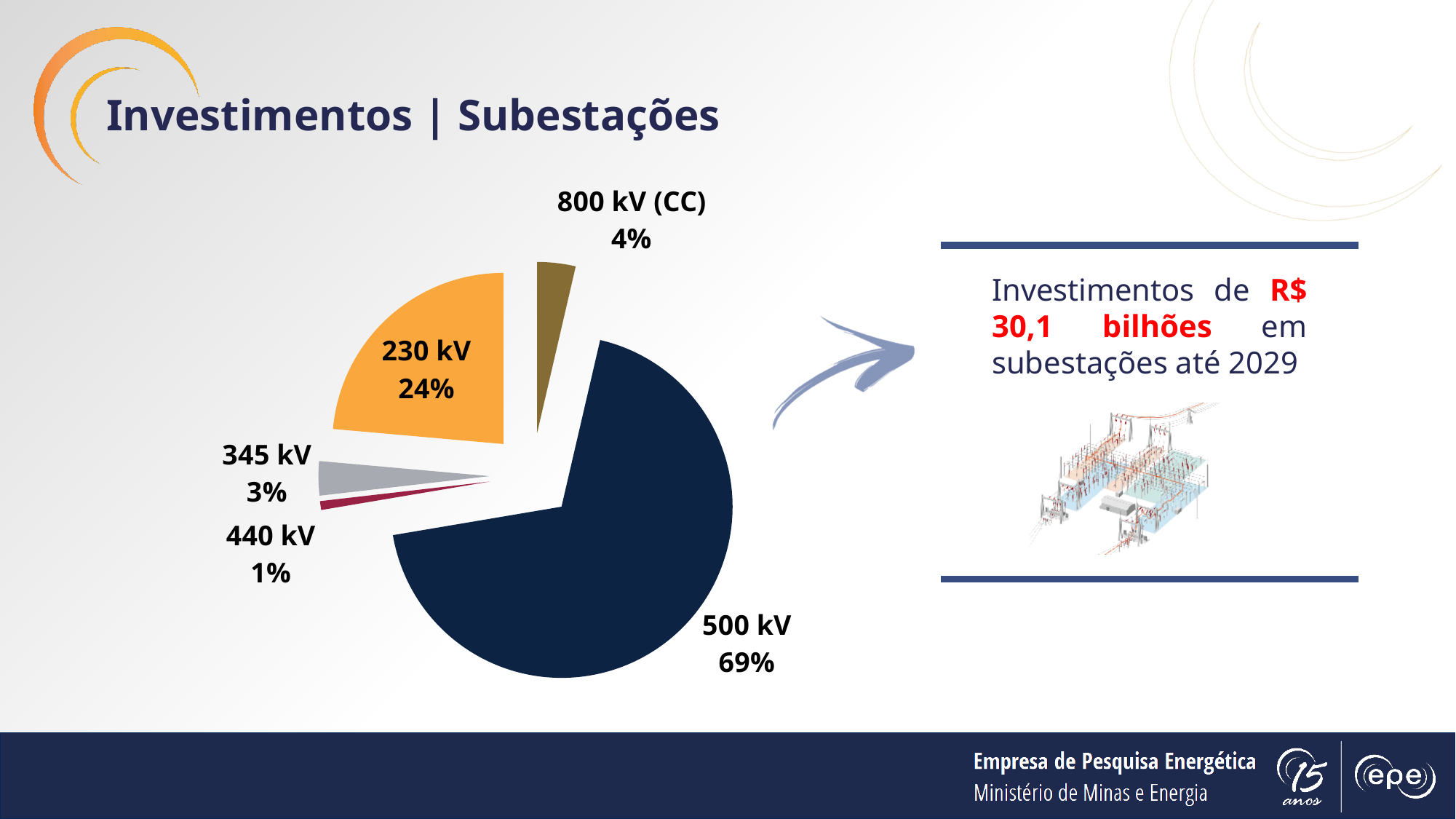
What is the value shown for 345 kV? 3% Which category has the smallest slice of the pie? 440 kV What colour is the 230 kV slice? Orange Which category has the largest slice of the pie? 500 kV Which is larger, the 800 kV (CC) slice or the 345 kV slice? 800 kV (CC) What is the value shown for 800 kV (CC)? 4% What kind of chart is shown on the slide? Pie chart What is the value shown for 440 kV? 1% How many slices does the pie chart have? 5 What share of the pie does the 500 kV slice represent? 69% What share of the pie does the 230 kV slice represent? 24% What is the difference in percentage points between the 500 kV and 230 kV slices? 45